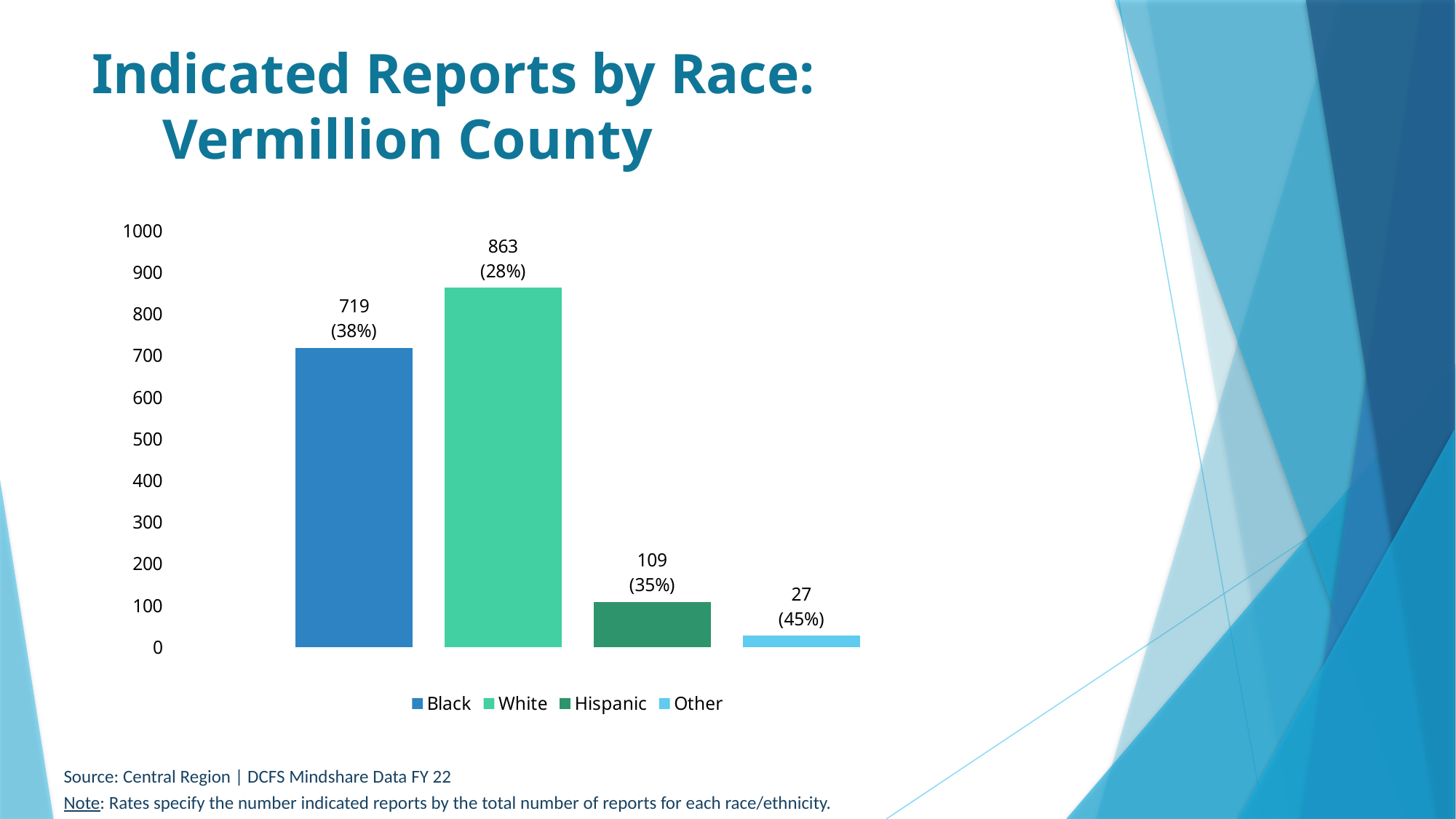
Is the value for Black greater or less than 600? greater What kind of chart is shown on the slide? Bar chart How many categories are shown in the chart? 4 What is the number of indicated reports for Hispanic? 109 What is the title of the chart on the slide? Indicated Reports by Race: Vermillion County What is the difference between the number of indicated reports for White and Black? 144 What is the number of indicated reports for Black? 719 What percentage is shown for the Other category? 45% Which category has the highest number of indicated reports? White Which category has the lowest number of indicated reports? Other Which has more indicated reports, Hispanic or Other? Hispanic What is the number of indicated reports for White? 863